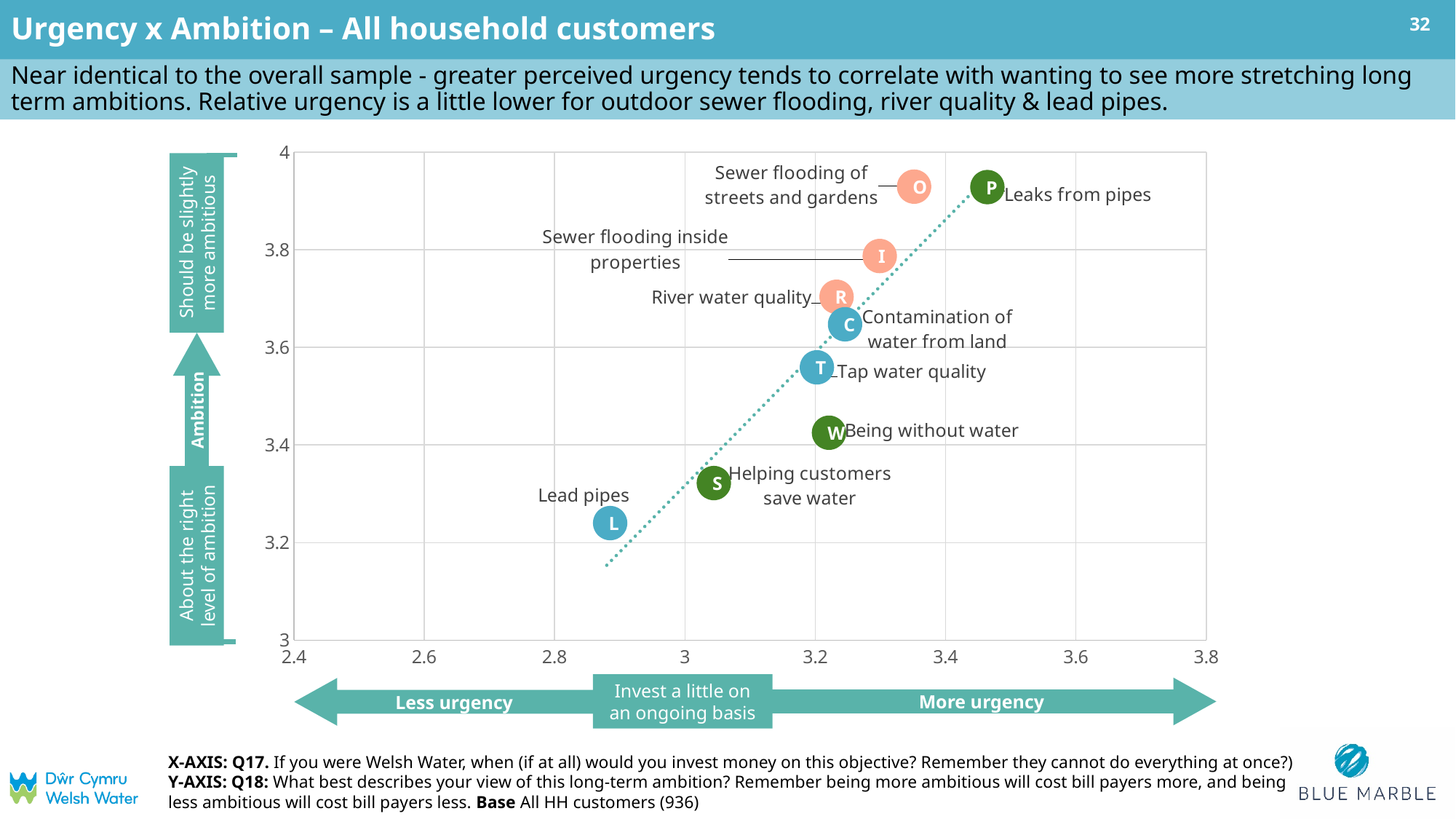
Is the ambition value (y axis) for Sewer flooding inside properties greater or less than 3.6? greater Which objective has the lowest urgency score (x axis)? Lead pipes Is the urgency value (x axis) for Lead pipes greater or less than 3? less Is the ambition value (y axis) for Helping customers save water greater or less than 3.4? less Which objective has the lowest ambition score (y axis)? Lead pipes What label is shown on the right end of the horizontal arrow below the x axis? More urgency What kind of chart is shown on the slide? scatter chart How many objectives are plotted on the chart? 9 Which has the higher ambition score: Sewer flooding of streets and gardens or Being without water? Sewer flooding of streets and gardens As urgency increases along the x axis, does ambition generally rise or fall? rise Which objective has the highest urgency score (x axis)? Leaks from pipes